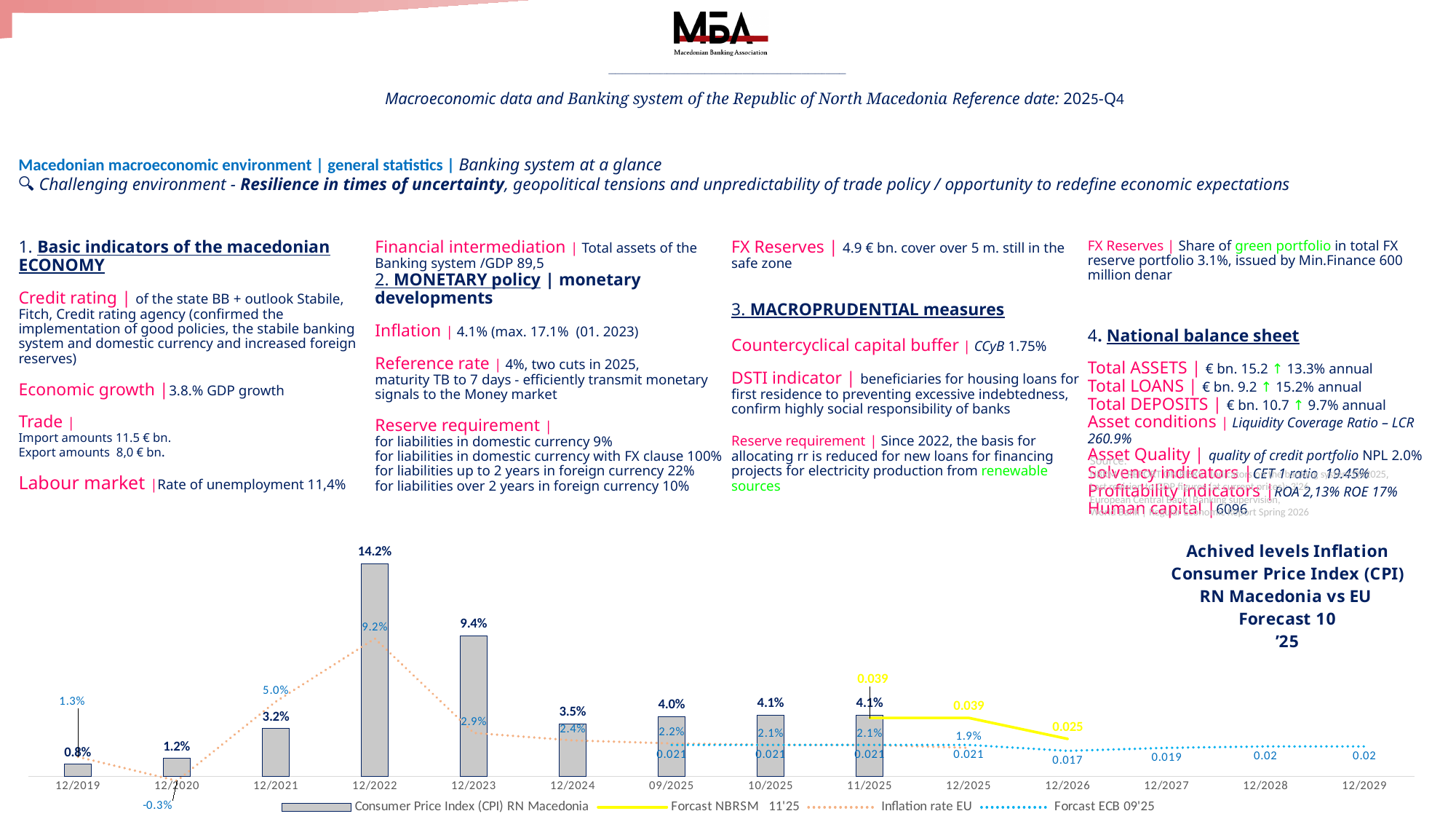
What kind of chart is used for the Consumer Price Index (CPI) RN Macedonia series? Bar chart How many series does the chart legend list? 4 What is the Consumer Price Index (CPI) RN Macedonia value for 12/2022? 14.2% For 12/2021, which is larger: the CPI RN Macedonia value or the Inflation rate EU value? Inflation rate EU How many periods are shown on the x axis of the chart? 14 What is the difference between the CPI RN Macedonia values for 12/2022 and 12/2023? 4.8 percentage points What is the Forcast ECB 09'25 value for 12/2026? 0.017 Do the CPI RN Macedonia bars rise or fall from 12/2022 to 12/2024? Fall Which period has the lowest Consumer Price Index (CPI) RN Macedonia bar? 12/2019 What is the Forcast NBRSM 11'25 value for 12/2026? 0.025 What is the Inflation rate EU value for 12/2020? -0.3% Which period has the highest Consumer Price Index (CPI) RN Macedonia bar? 12/2022